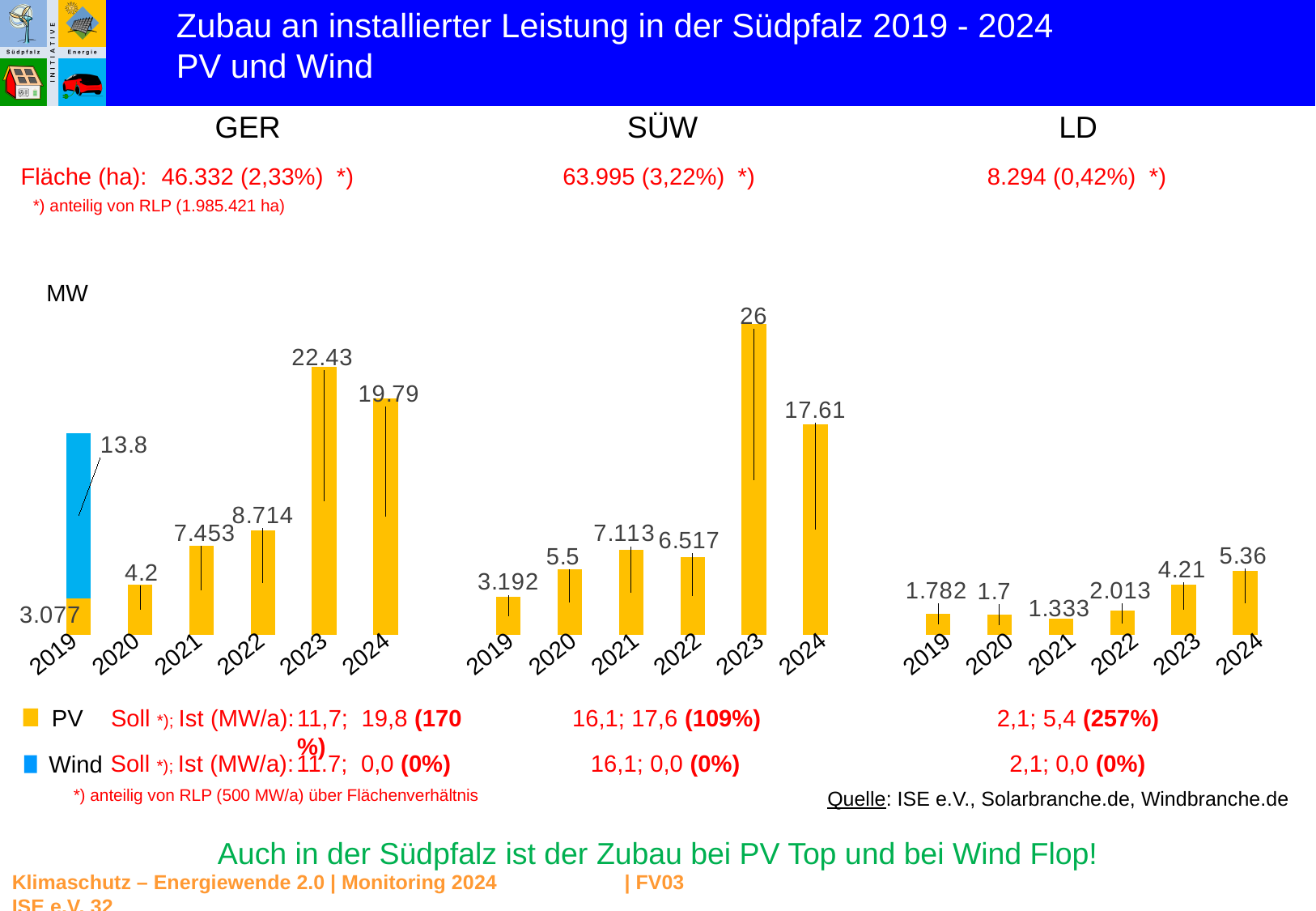
In the LD chart, which year has the lowest value? 2021 In the SÜW chart, which is larger, the value for 2021 or for 2022? 2021 In the SÜW chart, which year has the highest value? 2023 In the SÜW chart, what is the value for 2020? 5.5 In the SÜW chart, what is the difference between the 2023 and 2024 values? 8.39 What kind of chart is the GER chart? Bar chart How many series does the legend list? 2 In the GER chart, what is the PV value for 2023? 22.43 In the LD chart, what is the value for 2022? 2.013 How many years are shown on the x axis of the LD chart? 6 In the GER chart, what is the Wind value for 2019? 13.8 In the GER chart, what is the total of the stacked 2019 bar (PV plus Wind)? 16.877